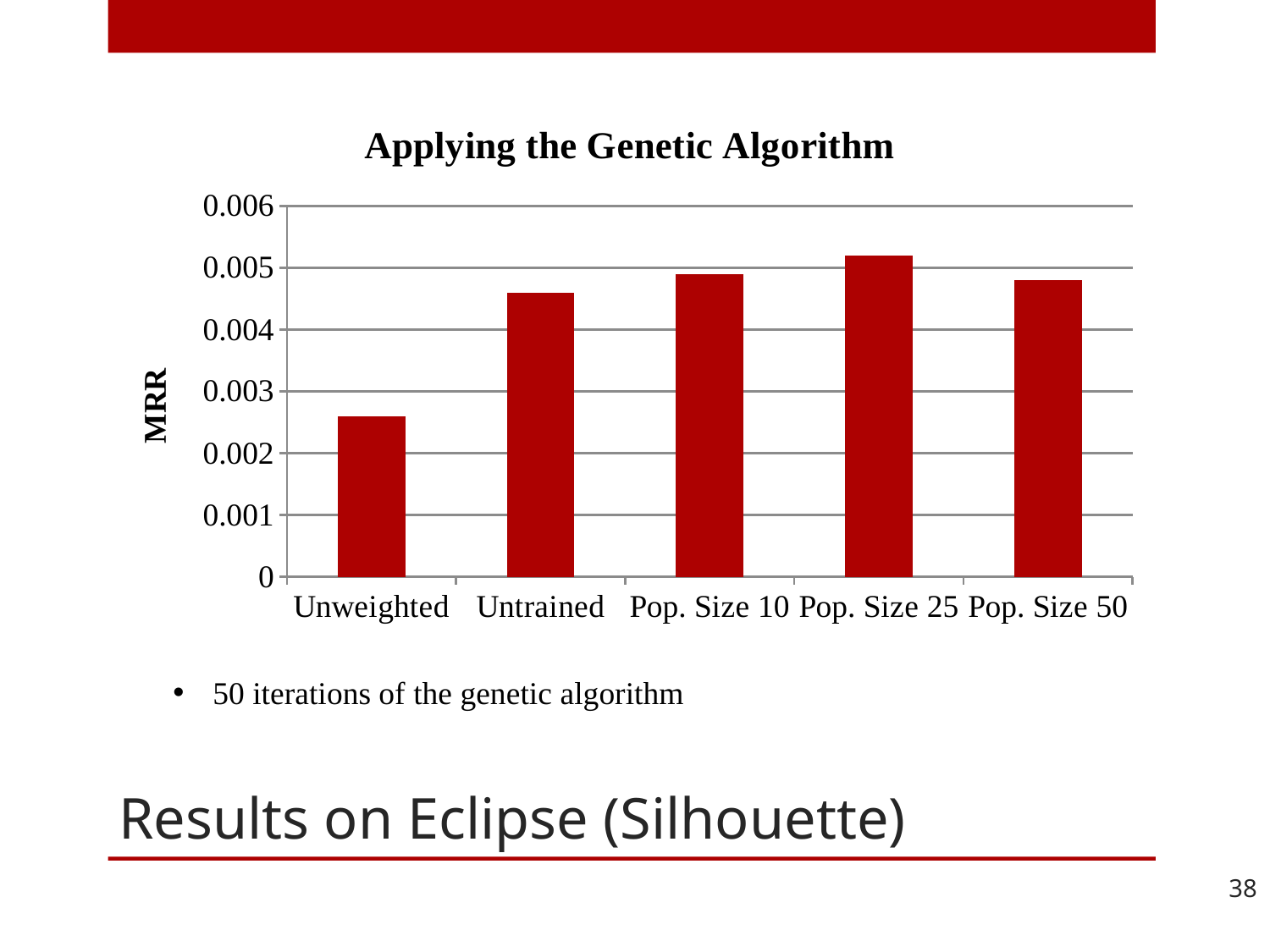
Is the MRR value for Pop. Size 25 greater or less than 0.005? greater Is the MRR value for Unweighted greater or less than 0.003? less What is the label on the vertical axis of the chart? MRR Which category has the lowest MRR value? Unweighted Which category has the highest MRR value? Pop. Size 25 What is the title of the chart? Applying the Genetic Algorithm Is the MRR value for Untrained greater or less than 0.004? greater Which has a higher MRR value, Unweighted or Untrained? Untrained Which has a higher MRR value, Pop. Size 25 or Pop. Size 50? Pop. Size 25 How many categories are shown on the x axis of the chart? 5 What kind of chart is shown on the slide? bar chart